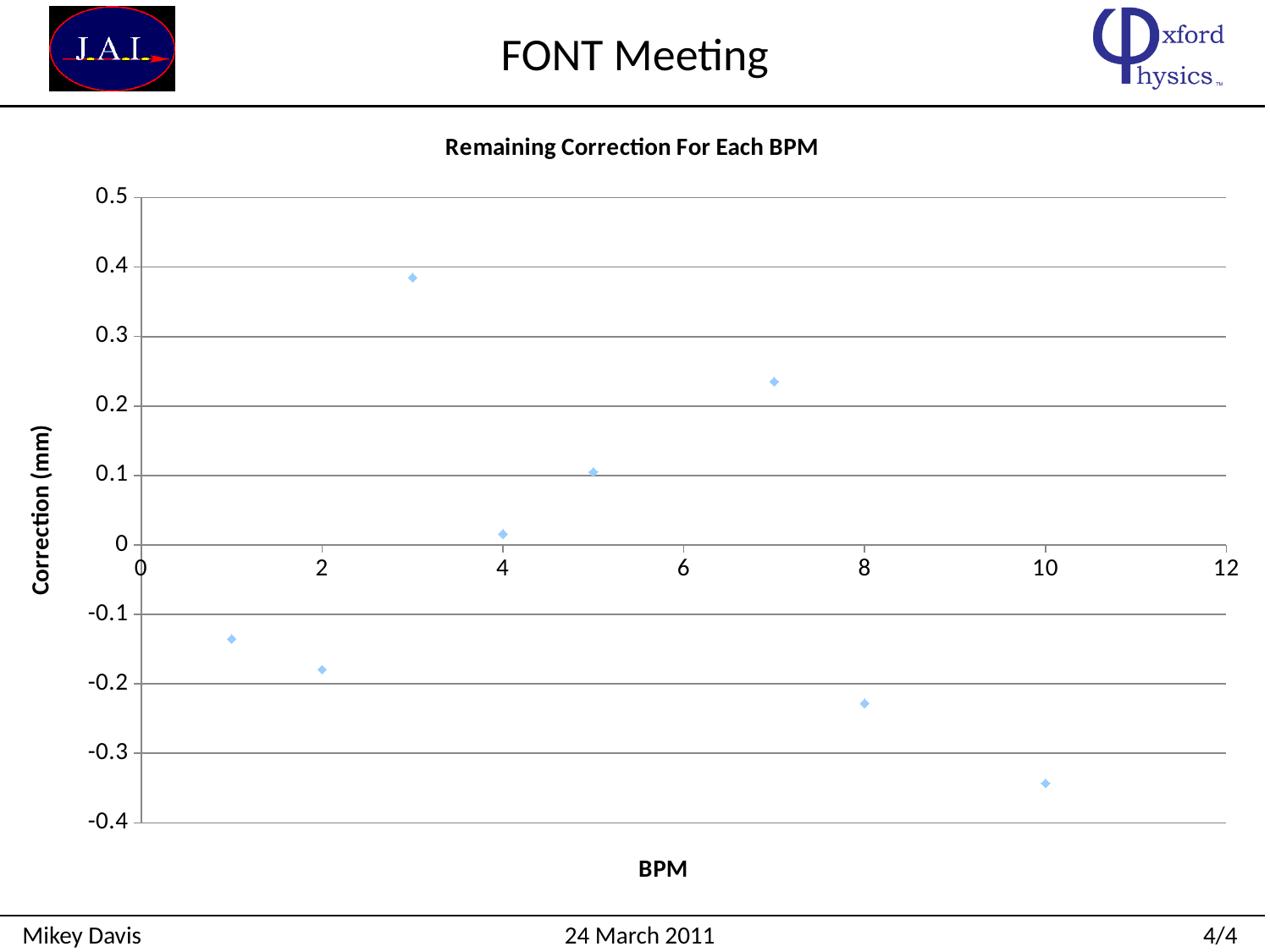
Which has the larger correction value, BPM 8 or BPM 10? BPM 8 What type of chart is shown on the slide? Scatter chart Which has the larger correction value, BPM 3 or BPM 7? BPM 3 Which BPM has the lowest correction value? BPM 10 Is the correction value for BPM 10 greater or less than -0.3? less How many data points are plotted on the chart? 8 Is the correction value for BPM 3 greater or less than 0.3? greater Is the correction value for BPM 8 greater or less than -0.2? less What is the label of the vertical axis? Correction (mm) What is the title of the chart? Remaining Correction For Each BPM Which BPM has the highest correction value? BPM 3